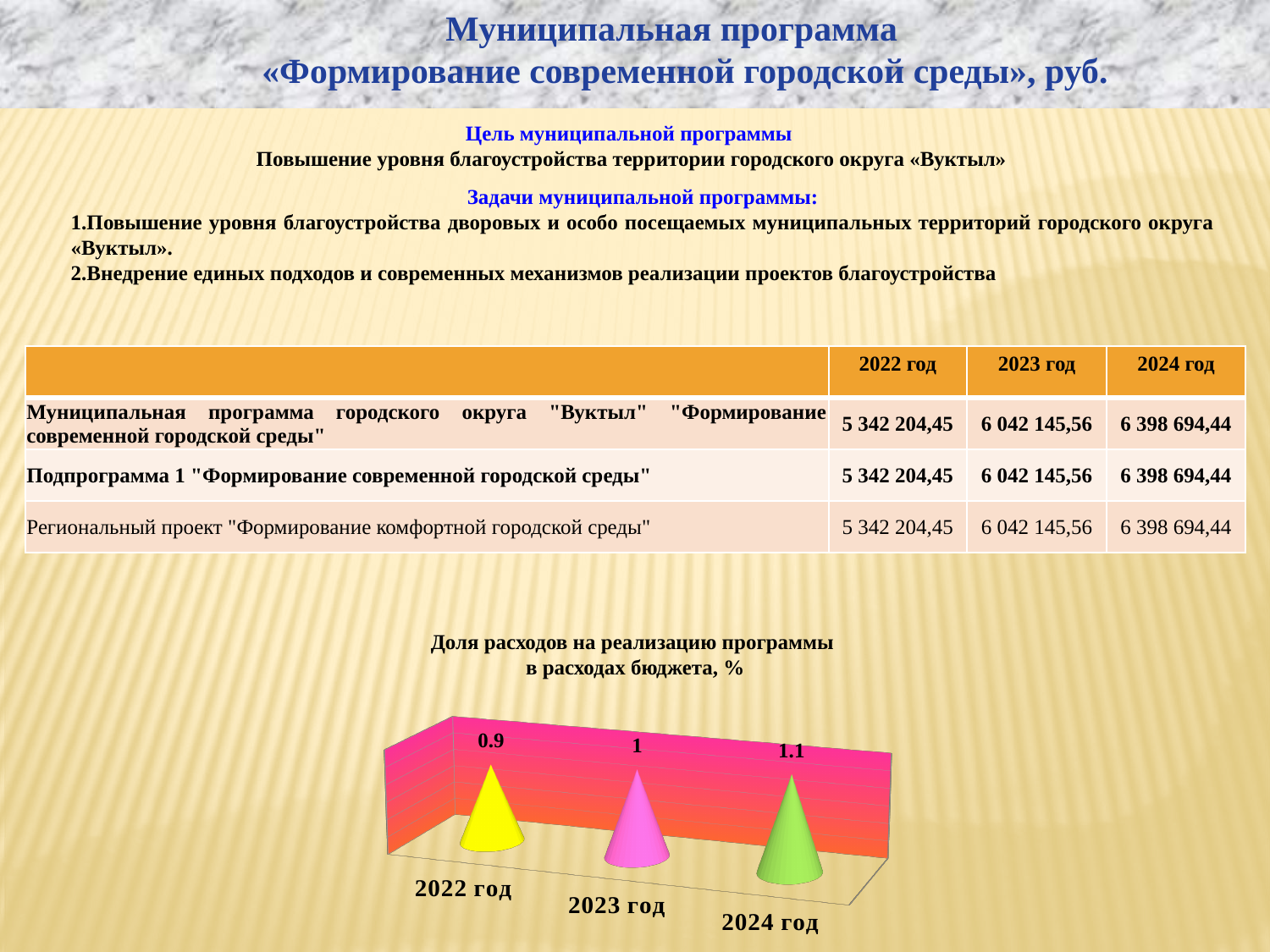
Which year has the highest value in the chart? 2024 год How many categories are plotted in the chart? 3 Which year has the lowest value in the chart? 2022 год What is the value for 2023 год in the chart? 1 What is the value for 2024 год in the chart? 1.1 What is the title of the chart? Доля расходов на реализацию программы в расходах бюджета, % Do the values rise or fall from 2022 год to 2024 год? rise What is the difference between the values for 2024 год and 2022 год? 0.2 Which is larger, the value for 2023 год or the value for 2022 год? 2023 год What colour is the cone for 2022 год? yellow What is the value for 2022 год in the chart? 0.9 What is the difference between the values for 2023 год and 2022 год? 0.1